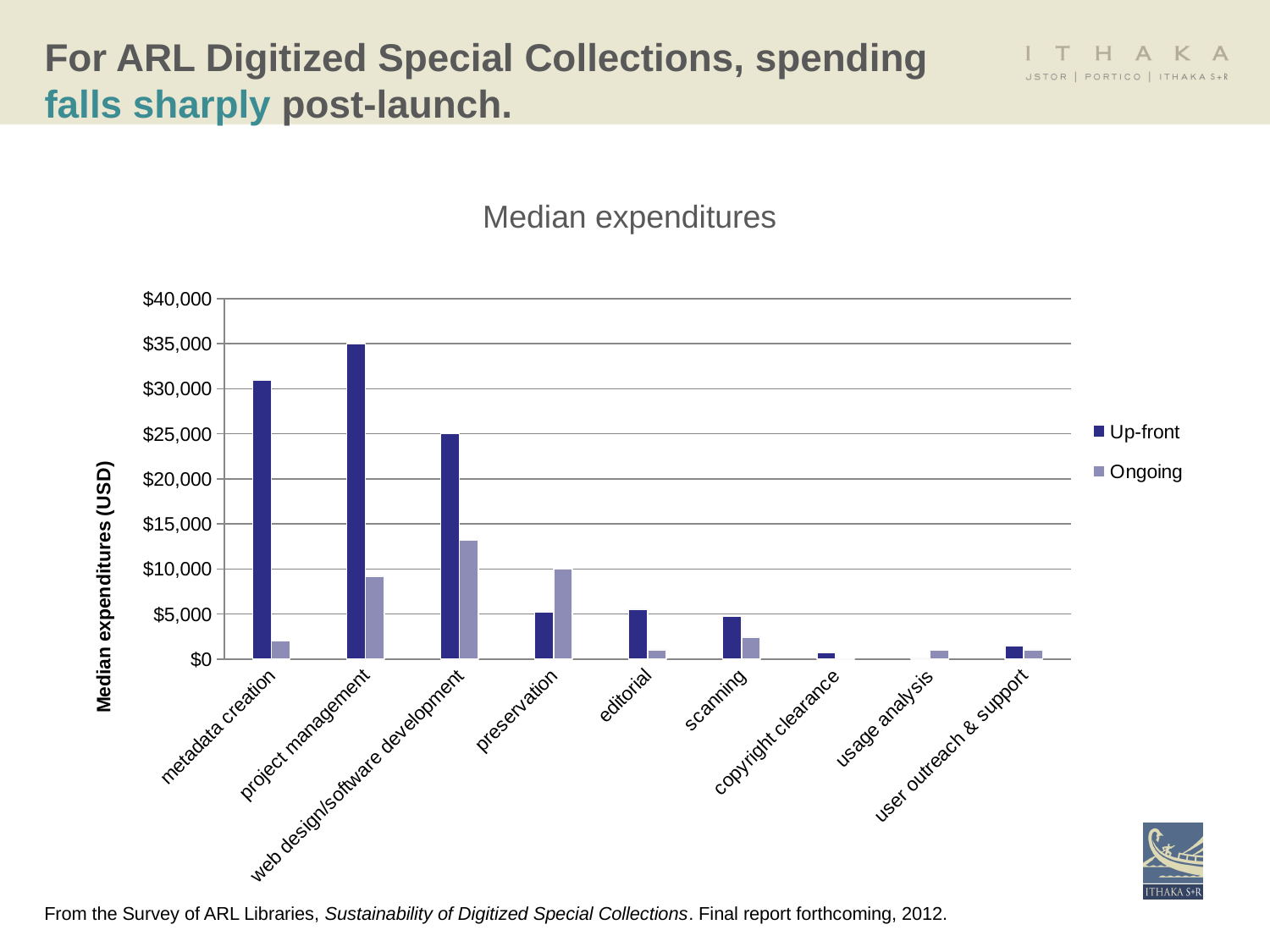
How many categories are shown on the x axis? 9 What is the label of the vertical axis? Median expenditures (USD) Is the Up-front value for metadata creation greater or less than $25,000? greater What type of chart is shown on the slide? bar chart Which category has the highest Ongoing median expenditure? web design/software development For preservation, which is larger: the Up-front or the Ongoing value? Ongoing How many series does the legend list? 2 What is the title of the chart? Median expenditures Is the Up-front value for project management greater or less than $30,000? greater Which category has the highest Up-front median expenditure? project management Is the Ongoing value for web design/software development greater or less than $10,000? greater